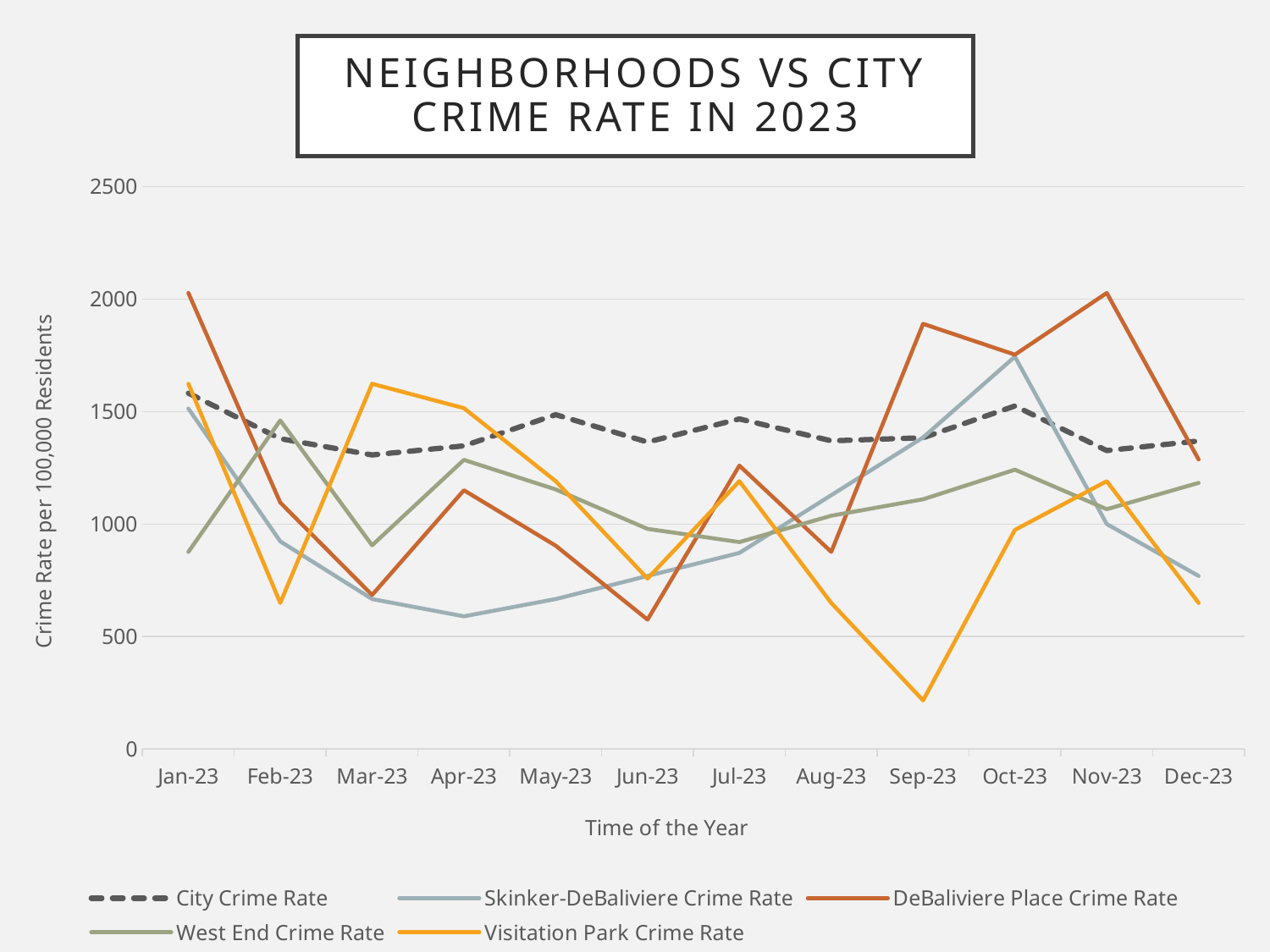
What kind of chart is shown on the slide? line chart Is the DeBaliviere Place Crime Rate in Jan-23 greater or less than 1500? greater Does the Skinker-DeBaliviere Crime Rate rise or fall from Jan-23 to Apr-23? fall Is the City Crime Rate in Mar-23 greater or less than 1500? less How many months are plotted along the x axis? 12 In Oct-23, which is higher: the Skinker-DeBaliviere Crime Rate or the City Crime Rate? Skinker-DeBaliviere Crime Rate How many series does the legend list? 5 Is the Skinker-DeBaliviere Crime Rate in Apr-23 greater or less than 1000? less In which month is the Skinker-DeBaliviere Crime Rate highest? Oct-23 In which month is the Visitation Park Crime Rate lowest? Sep-23 In Jun-23, which is higher: the DeBaliviere Place Crime Rate or the West End Crime Rate? West End Crime Rate